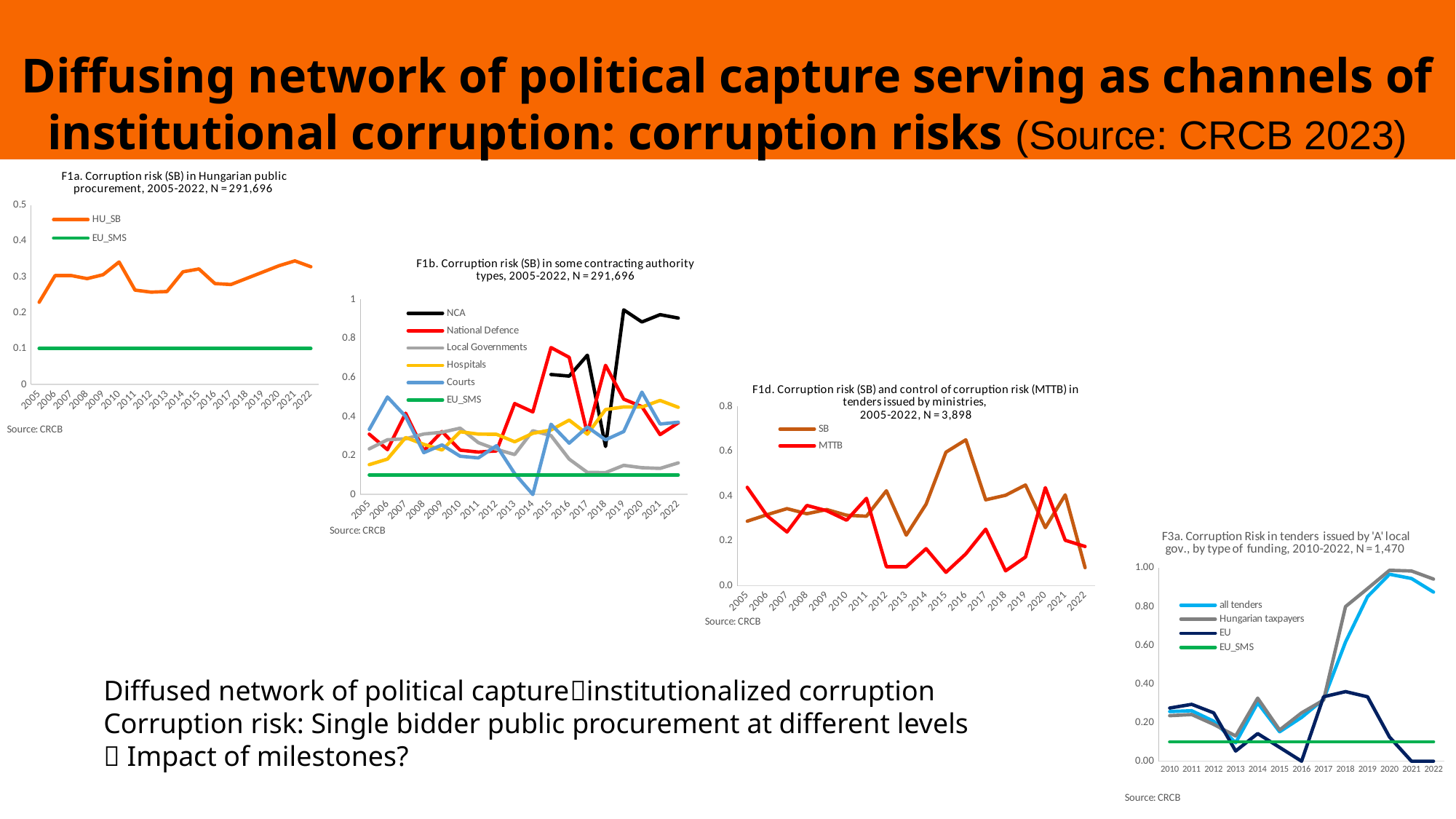
In chart F1a, how many series does the legend list? 2 In chart F1b, how many series does the legend list? 6 In chart F3a, how many series does the legend list? 4 In chart F1b, which series has the highest value in 2022? NCA In chart F1b, how many years are shown on the x axis? 18 In chart F3a, does the 'all tenders' line rise or fall from 2017 to 2020? rise In chart F1a, is the HU_SB value for 2012 greater or less than 0.3? less In chart F1d, which series is larger in 2016, SB or MTTB? SB In chart F1d, is the MTTB value for 2015 greater or less than 0.2? less What kind of chart is F1a, Corruption risk (SB) in Hungarian public procurement? line chart In chart F1b, is the NCA value for 2019 greater or less than 0.8? greater